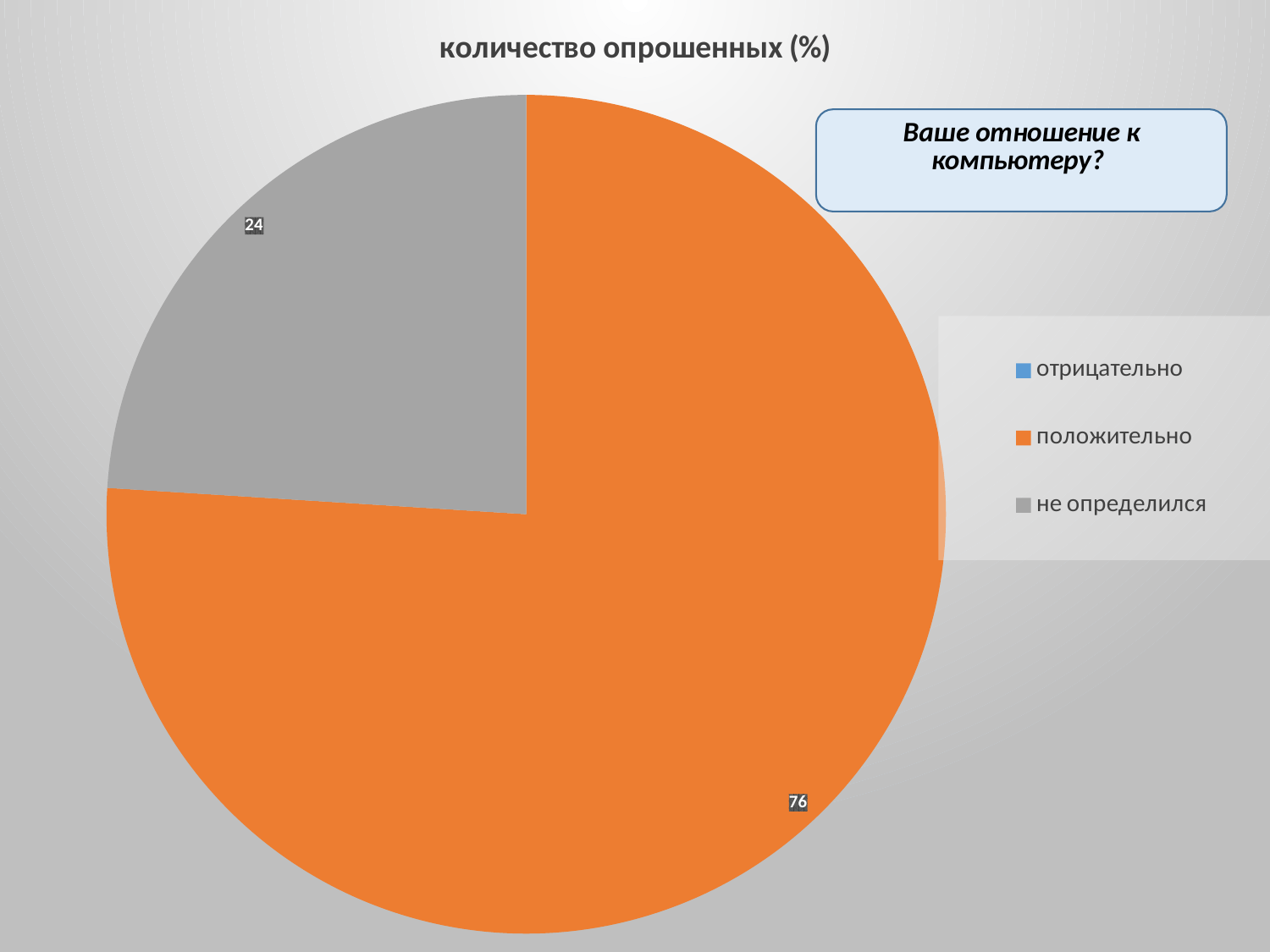
What share of the pie does не определился take? 24% How many slices are visible in the pie? 2 What is the value for положительно? 76 What colour is the slice for положительно? orange What is the title of the chart? количество опрошенных (%) Which of the two visible slices is larger, положительно or не определился? положительно What is the value for не определился? 24 How many entries does the legend list? 3 What is the difference between the values for положительно and не определился? 52 What share of the pie does положительно take? 76% What kind of chart is shown on the slide? pie chart Which category has the largest slice of the pie? положительно